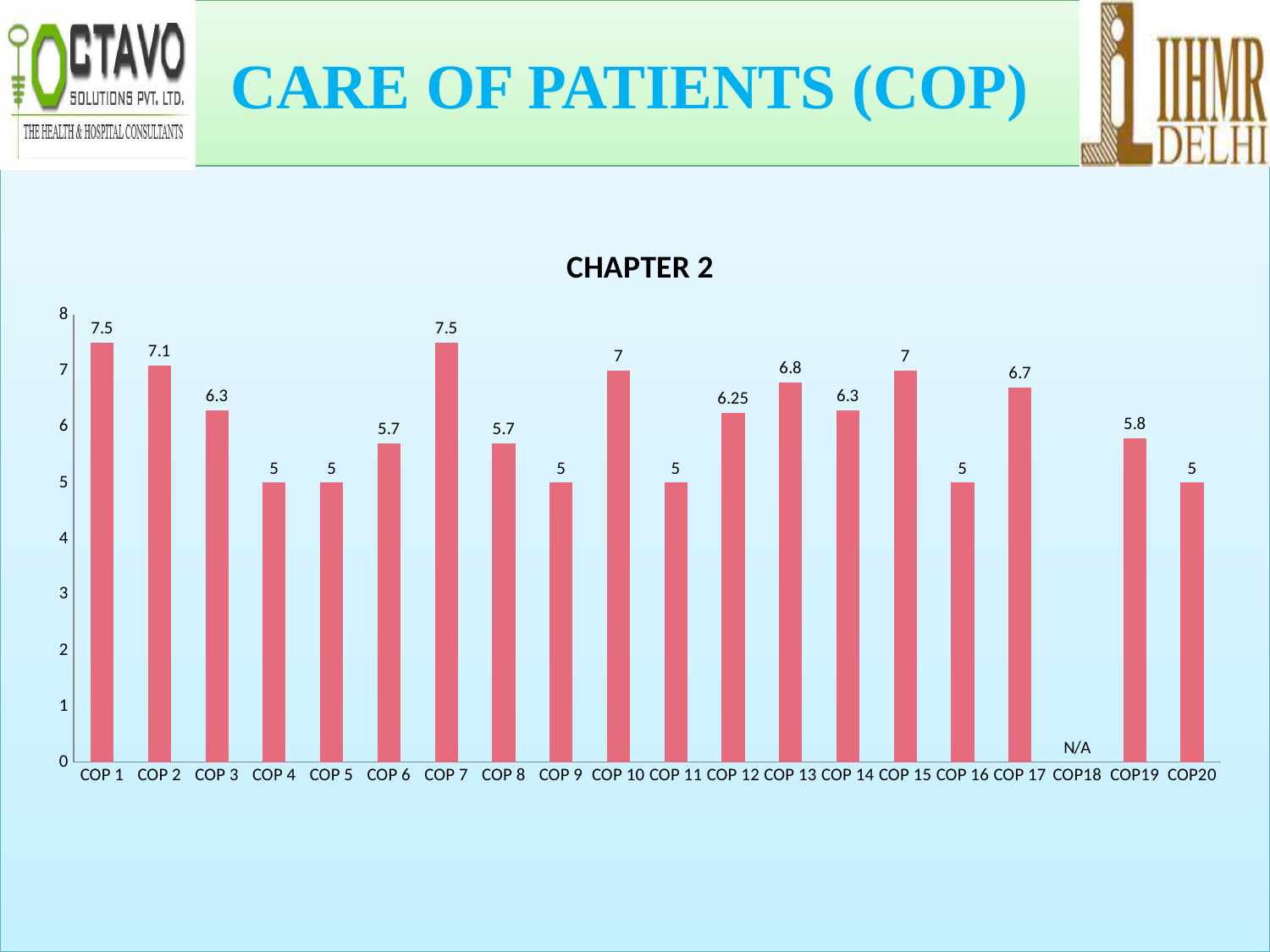
What is shown for COP18 in the CHAPTER 2 chart? N/A What is the value for COP 17 in the CHAPTER 2 chart? 6.7 What is the difference between the values for COP 1 and COP 3 in the CHAPTER 2 chart? 1.2 What is the value for COP19 in the CHAPTER 2 chart? 5.8 What is the difference between the values for COP 13 and COP 14 in the CHAPTER 2 chart? 0.5 What kind of chart is the CHAPTER 2 chart? bar chart Which is larger in the CHAPTER 2 chart, the value for COP 10 or the value for COP 6? COP 10 What is the value for COP 12 in the CHAPTER 2 chart? 6.25 What is the value for COP 2 in the CHAPTER 2 chart? 7.1 Which categories have the highest value in the CHAPTER 2 chart? COP 1 and COP 7 Is the value for COP 15 greater or less than 6 in the CHAPTER 2 chart? greater How many categories are shown on the x axis of the CHAPTER 2 chart? 20